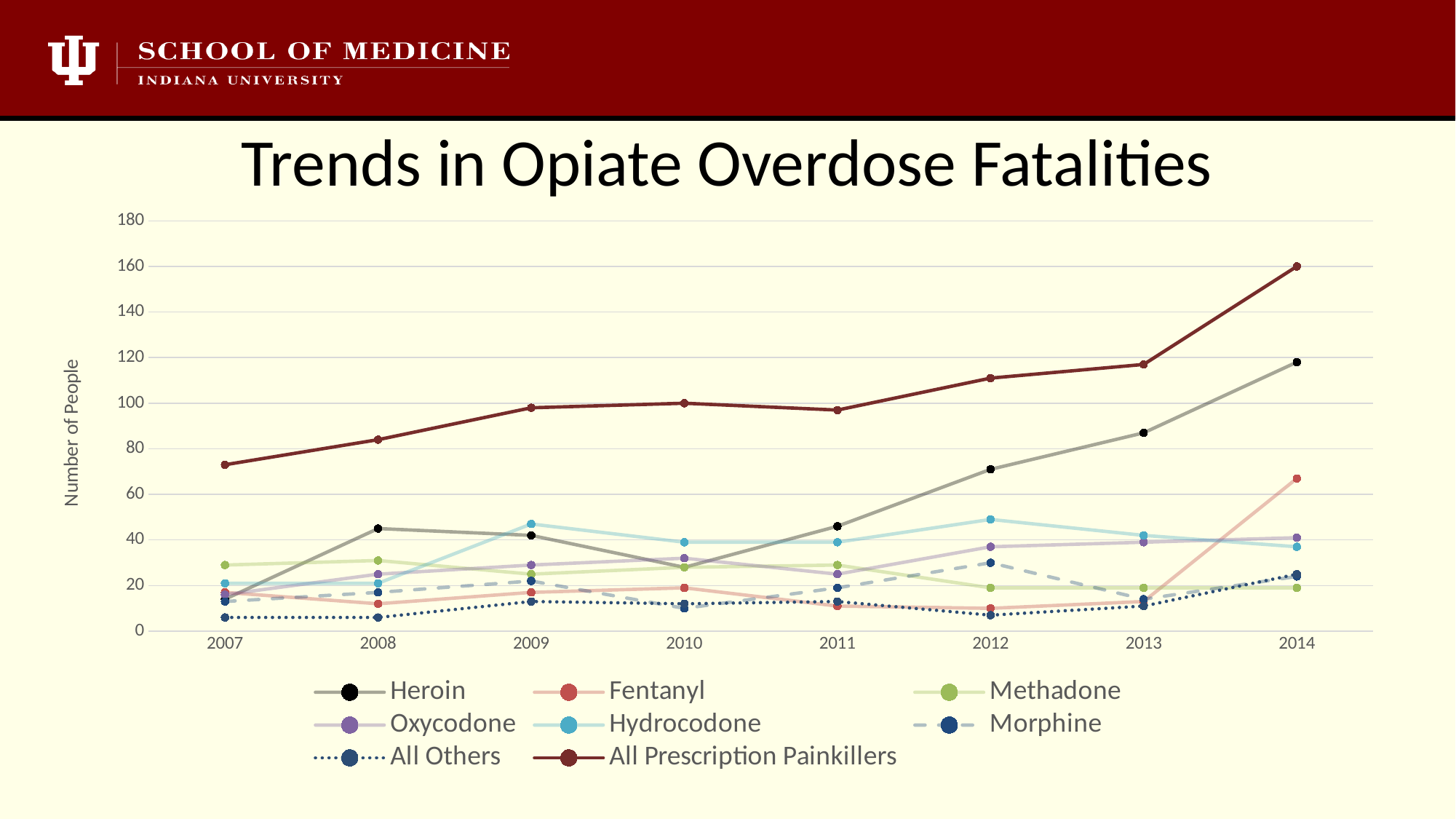
In 2014, which is larger: the value for Heroin or the value for Fentanyl? Heroin Is the value for Fentanyl in 2014 greater or less than 60? greater Which series has the highest value in 2014? All Prescription Painkillers In which year does the Heroin series reach its highest value? 2014 In which year is the Heroin series at its lowest value? 2007 What is the label on the vertical axis? Number of People How many series does the legend list? 8 How many years are shown along the x axis? 8 What kind of chart is shown on the slide? line chart Does the All Prescription Painkillers series generally rise or fall from 2007 to 2014? rise Is the value for All Prescription Painkillers in 2007 greater or less than 80? less Is the value for Heroin in 2014 greater or less than 100? greater